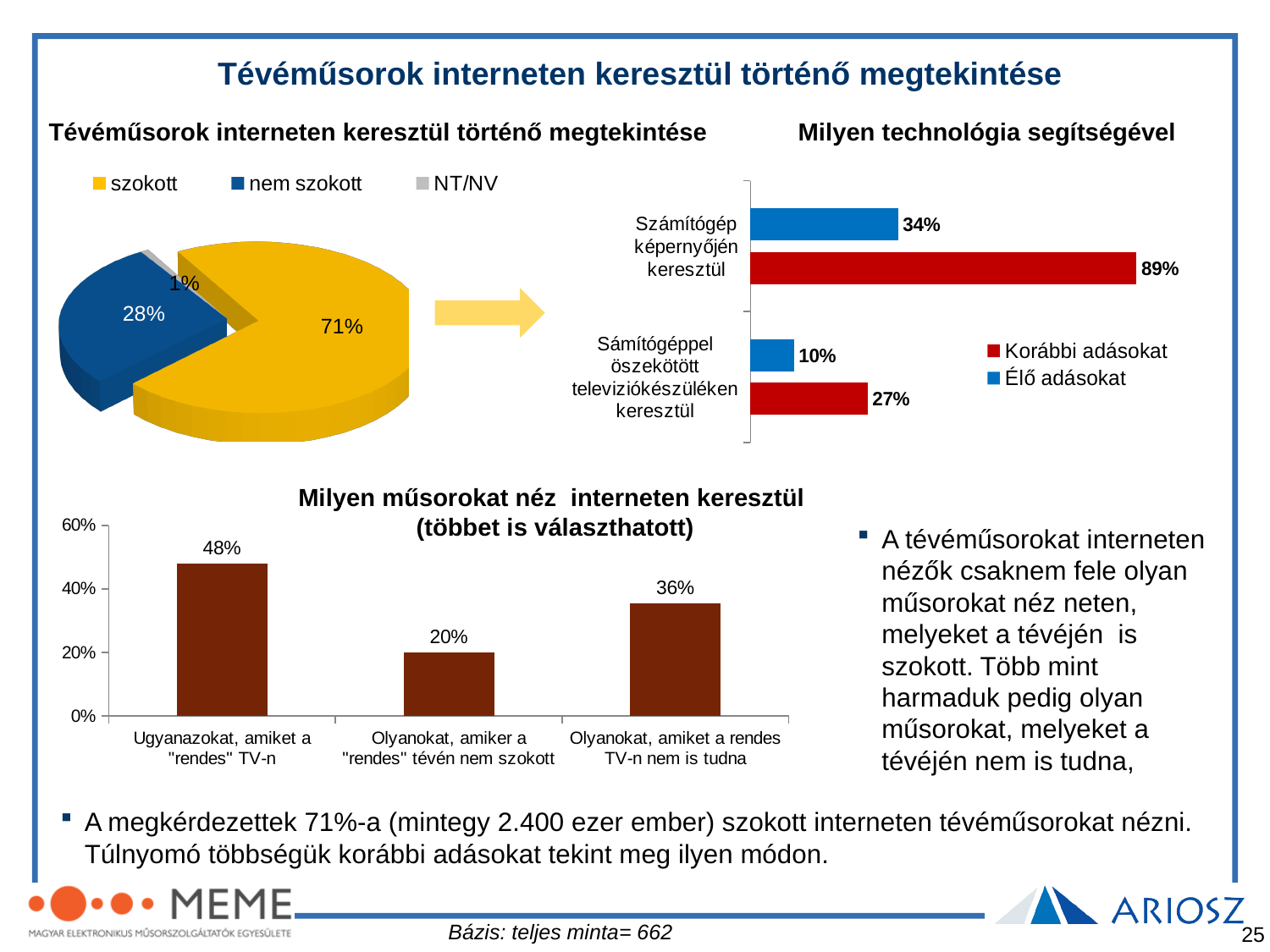
In the chart titled "Milyen technológia segítségével", what is the value for "Élő adásokat" for "Sámítógéppel öszekötött televiziókészüléken keresztül"? 10% In the chart titled "Milyen technológia segítségével", what is the value for "Korábbi adásokat" for "Számítógép képernyőjén keresztül"? 89% In the pie chart on the top left, what share of respondents answered "szokott"? 71% How many entries does the legend of the pie chart on the top left list? 3 In the chart titled "Milyen technológia segítségével", what is the difference between the two values for "Számítógép képernyőjén keresztül"? 55% In the chart titled "Milyen műsorokat néz interneten keresztül", which is larger: the value for "Ugyanazokat, amiket a "rendes" TV-n" or for "Olyanokat, amiket a rendes TV-n nem is tudna"? Ugyanazokat, amiket a "rendes" TV-n What kind of chart is the one titled "Milyen technológia segítségével"? Bar chart In the chart titled "Milyen műsorokat néz interneten keresztül", what is the value for "Olyanokat, amiker a "rendes" tévén nem szokott"? 20% In the pie chart on the top left, which category has the smallest slice? NT/NV In the chart titled "Milyen műsorokat néz interneten keresztül", which category has the highest value? Ugyanazokat, amiket a "rendes" TV-n In the chart titled "Milyen műsorokat néz interneten keresztül", how many categories are shown? 3 In the pie chart on the top left, what share is shown for "nem szokott"? 28%